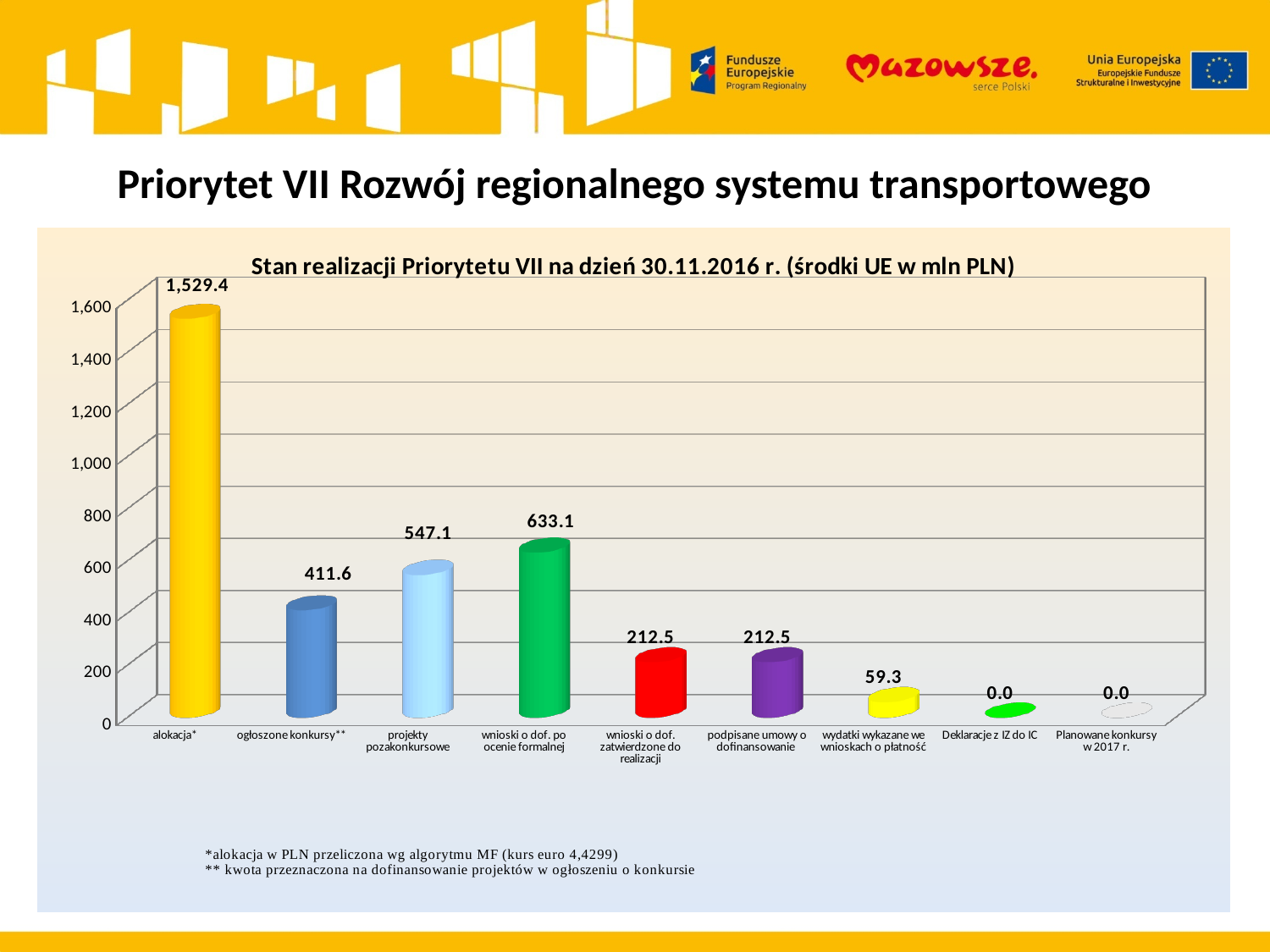
How many categories are shown on the x axis of the chart? 9 What is the difference between the values for wnioski o dof. po ocenie formalnej and projekty pozakonkursowe? 86.0 What is the value for wnioski o dof. po ocenie formalnej? 633.1 Which category has the highest value in the chart? alokacja* What is the title of the chart? Stan realizacji Priorytetu VII na dzień 30.11.2016 r. (środki UE w mln PLN) What is the value for alokacja* in the chart? 1,529.4 Which is larger: the value for projekty pozakonkursowe or the value for ogłoszone konkursy**? projekty pozakonkursowe What is the value for ogłoszone konkursy** in the chart? 411.6 What is the value for Deklaracje z IZ do IC? 0.0 What is the difference between the values for alokacja* and ogłoszone konkursy**? 1,117.8 Is the value for alokacja* greater or less than 1,400? greater What is the value for wydatki wykazane we wnioskach o płatność? 59.3